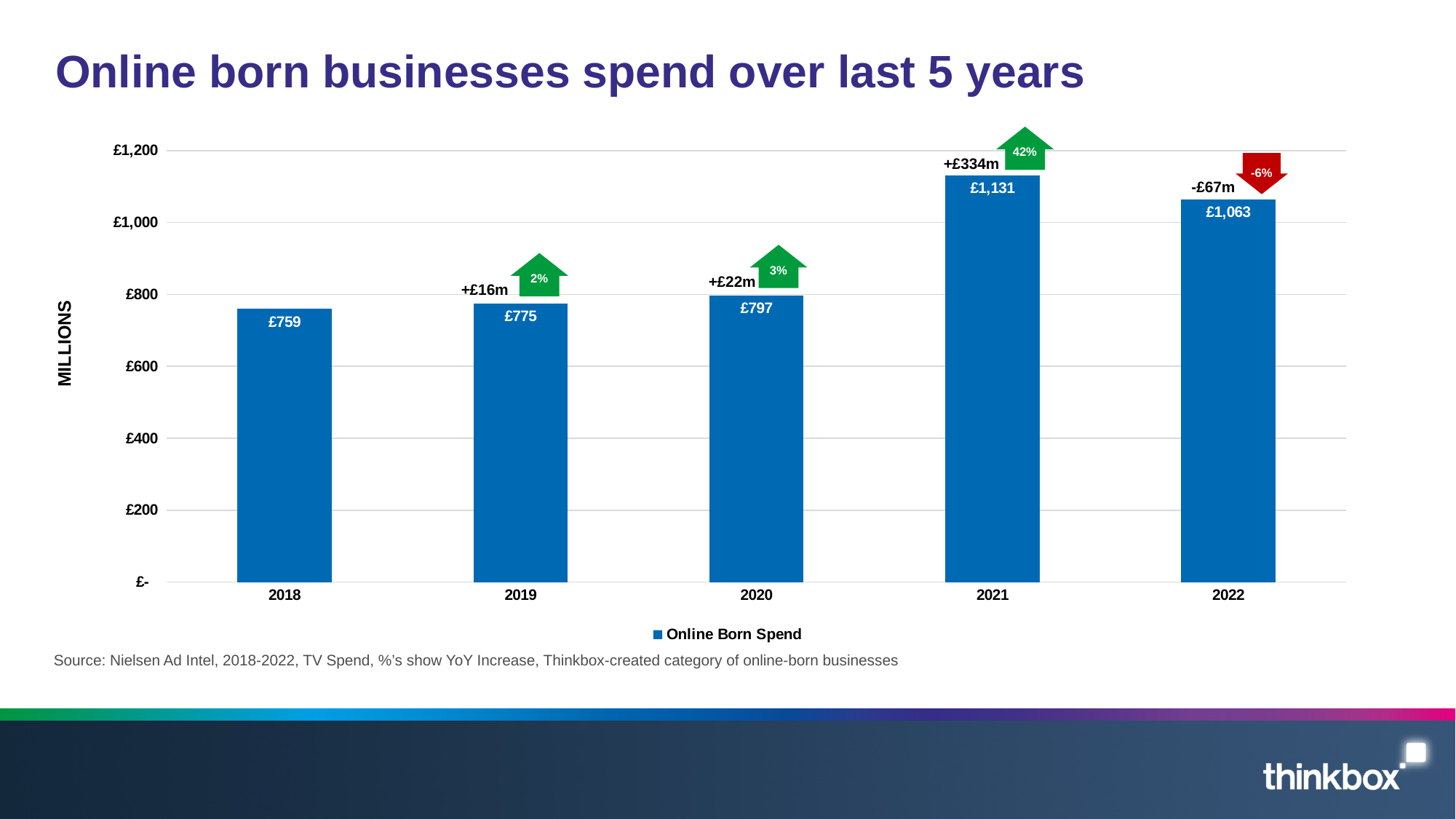
Is the Online Born Spend for 2020 greater or less than £1,000? less Which year has a larger Online Born Spend, 2019 or 2020? 2020 What is the y-axis label of the chart? MILLIONS How many series does the legend list? 1 What is the difference between the Online Born Spend in 2021 and 2022? £68 What is the Online Born Spend value for 2021? £1,131 Which year has the lowest Online Born Spend? 2018 Which year has the highest Online Born Spend? 2021 What kind of chart is shown on the slide? bar chart How many years are shown on the x axis? 5 What is the Online Born Spend value for 2022? £1,063 What is the Online Born Spend value for 2018? £759